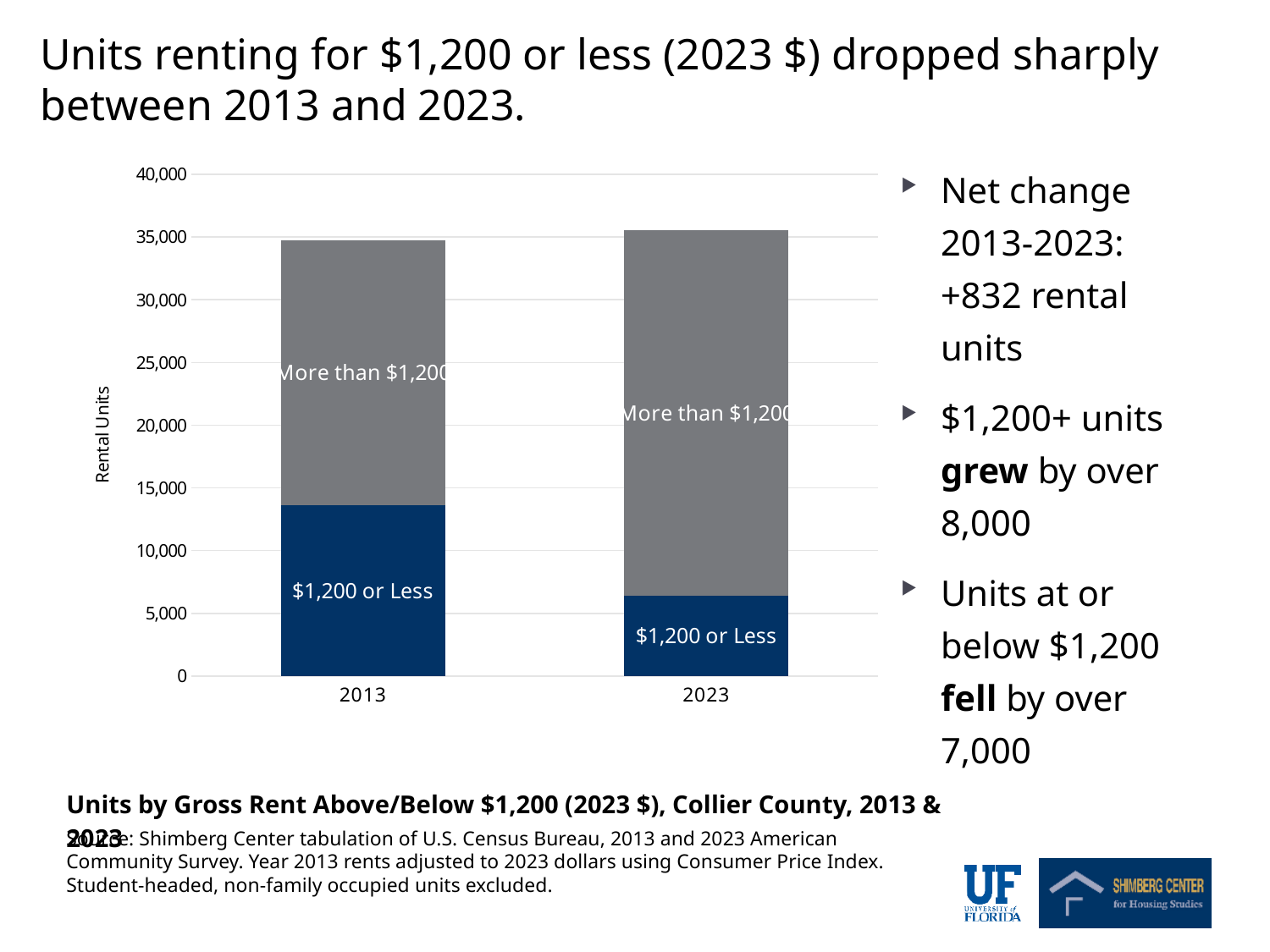
What kind of chart is shown on the slide? Stacked bar chart Is the total number of rental units in 2013 greater or less than 30,000? greater How many years (categories) are shown on the x axis of the chart? 2 Is the total number of rental units in 2023 greater or less than 40,000? less Which year has more units renting for $1,200 or less, 2013 or 2023? 2013 What is the label on the vertical axis of the chart? Rental Units Does the '$1,200 or Less' segment rise or fall from 2013 to 2023? Fall Which year has more units renting for more than $1,200, 2013 or 2023? 2023 Which county does the chart title say the data is for? Collier County Is the number of units renting for $1,200 or less in 2023 greater or less than 10,000? less How many rent segments (series) are stacked in each bar? 2